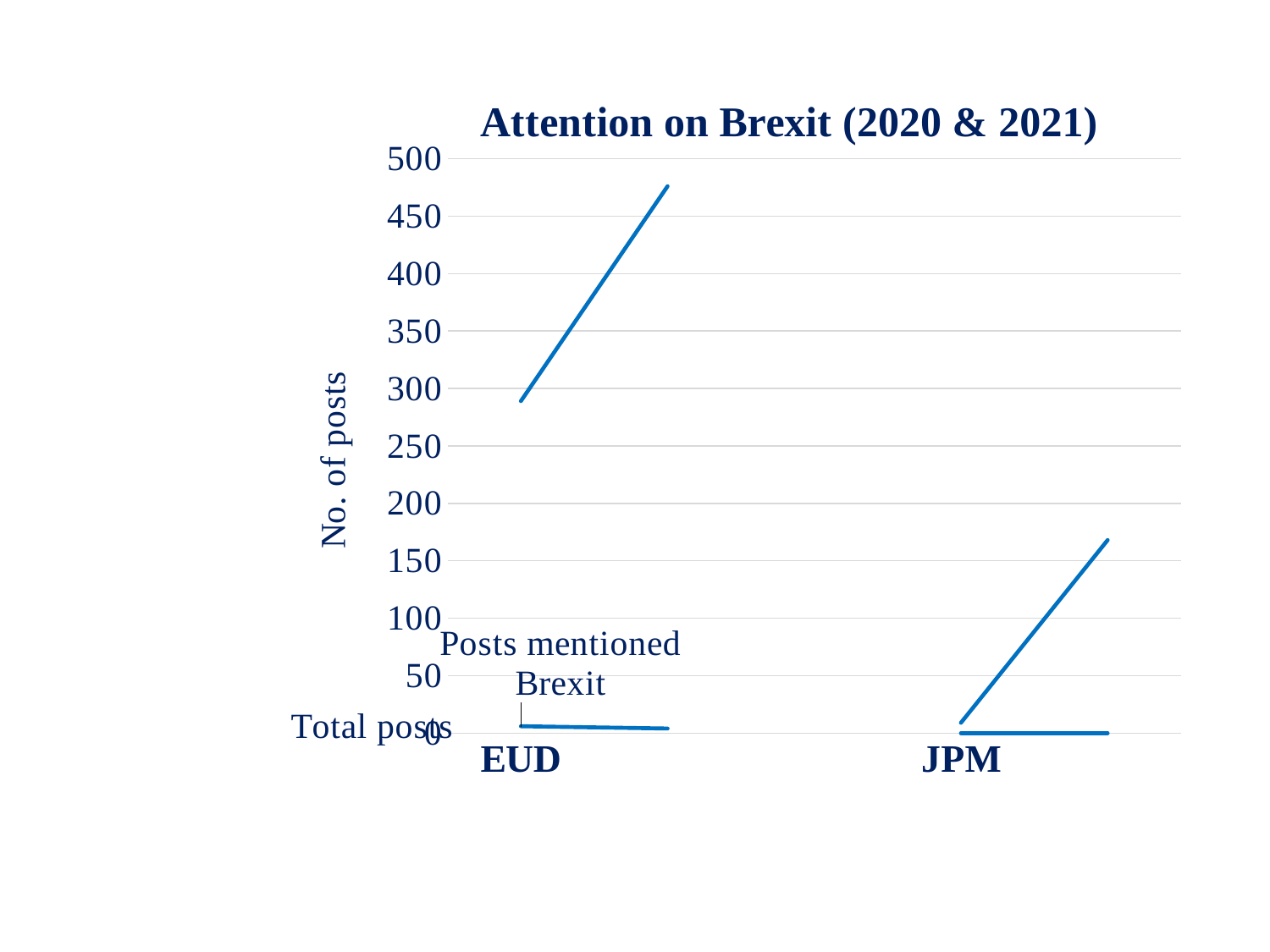
Does the rising line for EUD go up or down from left to right? up Is the lowest point of the rising EUD line greater or less than 250? greater What is the highest value shown on the vertical axis of the chart? 500 What kind of chart is shown on the slide? line chart Is the highest point of the JPM line greater or less than 150? greater What is the label on the vertical axis of the chart? No. of posts How many categories are shown on the horizontal axis of the chart? 2 Which category, EUD or JPM, reaches the higher number of posts on the chart? EUD Is the highest point of the EUD line greater or less than 450? greater What is the title of the chart? Attention on Brexit (2020 & 2021)